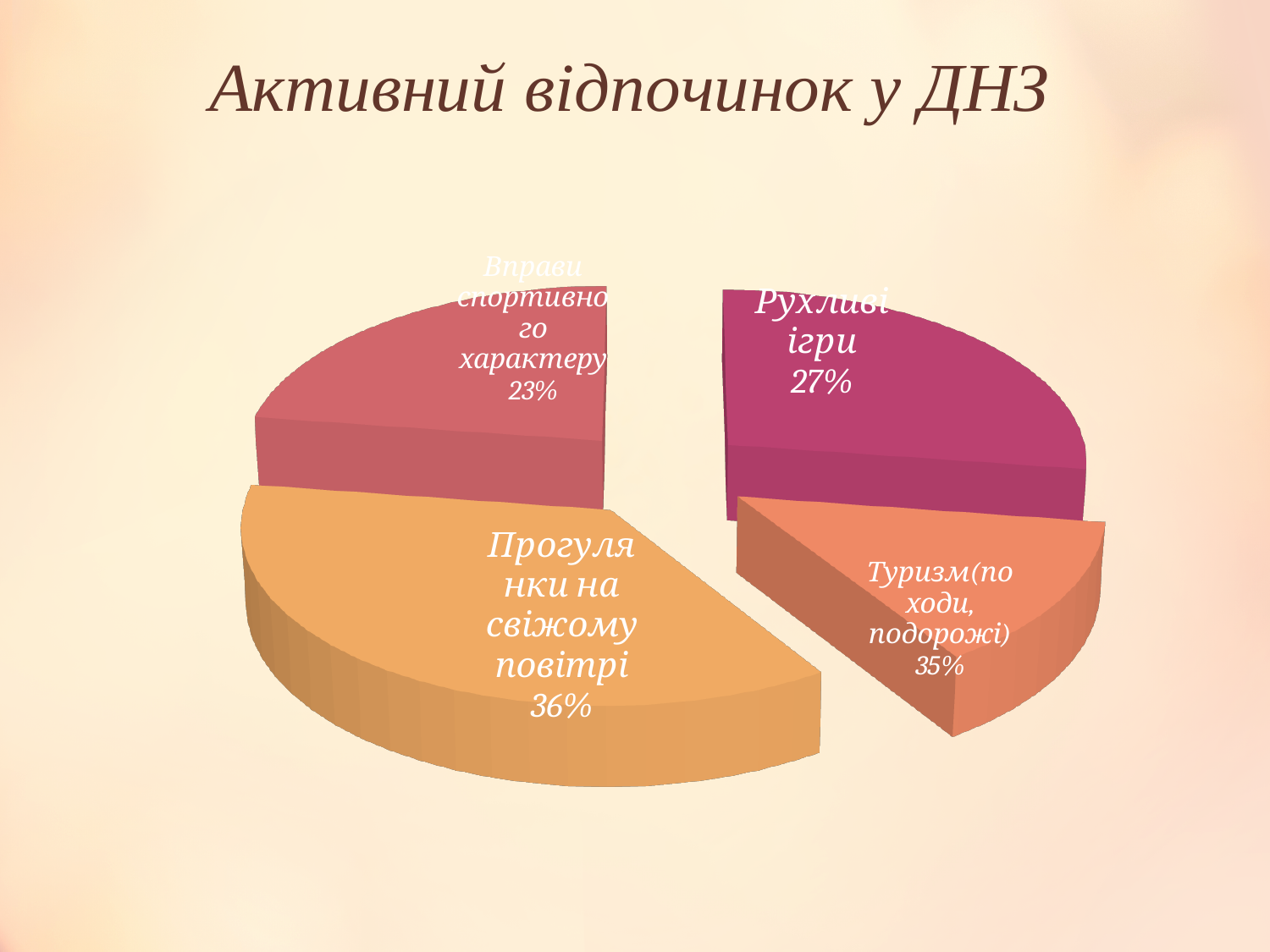
What share of the pie is labelled "Туризм(по ходи, подорожі)"? 35% What share of the pie is labelled "Рухливі ігри"? 27% Which slice has the largest share? Прогулянки на свіжому повітрі How many slices does the pie chart have? 4 What is the title of the chart? Активний відпочинок у ДНЗ What share of the pie is labelled "Прогулянки на свіжому повітрі"? 36% What is the difference between the share for "Прогулянки на свіжому повітрі" and the share for "Вправи спортивного характеру"? 13% What type of chart is shown on the slide? pie chart Which is larger: the share for "Рухливі ігри" or the share for "Вправи спортивного характеру"? Рухливі ігри